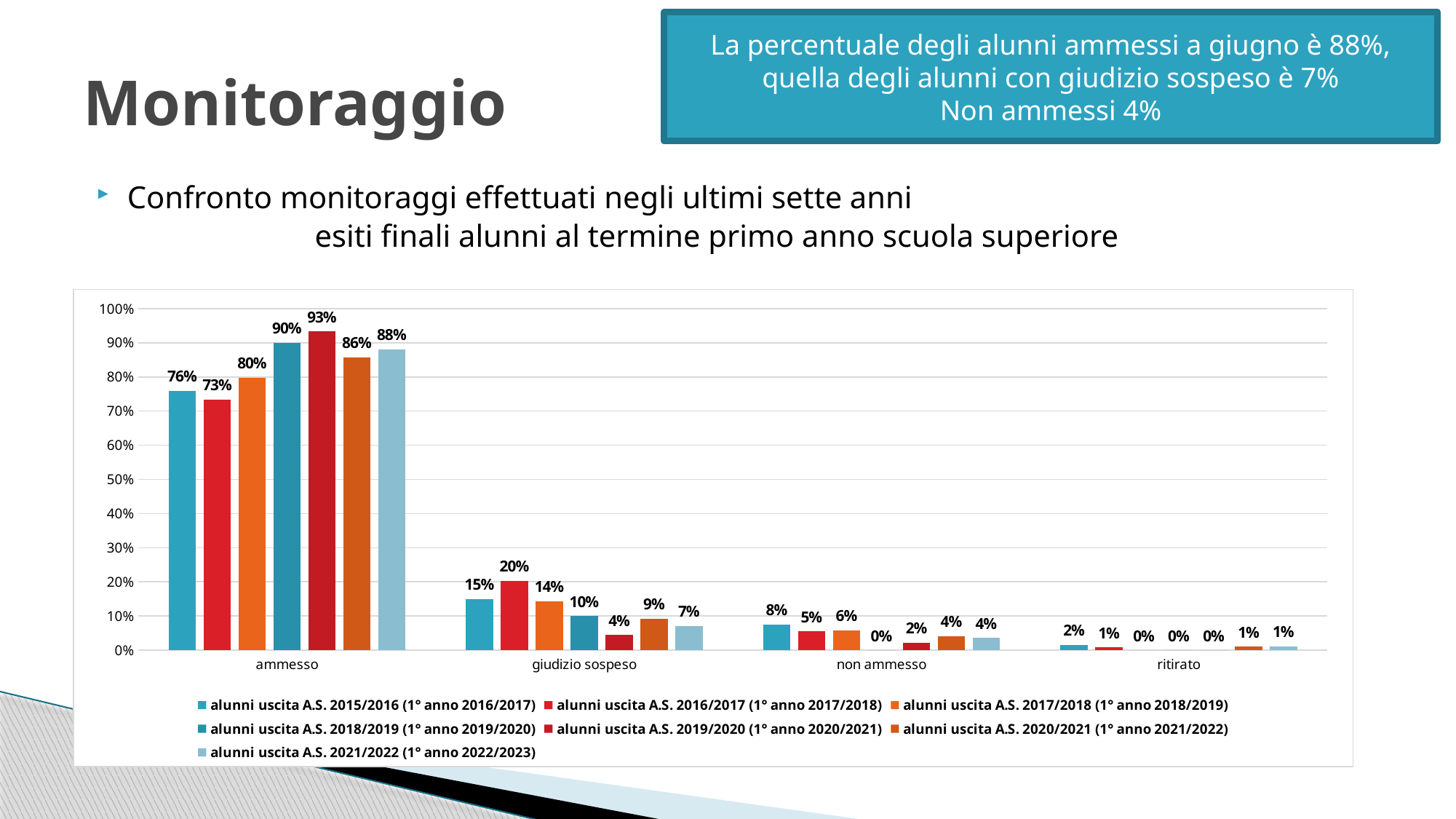
What kind of chart is shown on the slide? bar chart Which series has the lowest value for 'ammesso'? alunni uscita A.S. 2016/2017 (1° anno 2017/2018) How many categories are shown on the x axis of the chart? 4 For 'giudizio sospeso', which is larger: the value for 'alunni uscita A.S. 2017/2018 (1° anno 2018/2019)' or for 'alunni uscita A.S. 2018/2019 (1° anno 2019/2020)'? alunni uscita A.S. 2017/2018 (1° anno 2018/2019) Is the 'ammesso' value for 'alunni uscita A.S. 2018/2019 (1° anno 2019/2020)' greater or less than 80%? greater What is the value for 'non ammesso' for the series 'alunni uscita A.S. 2015/2016 (1° anno 2016/2017)'? 8% How many series does the chart's legend list? 7 What is the value for 'ritirato' for the series 'alunni uscita A.S. 2015/2016 (1° anno 2016/2017)'? 2% Which series has the highest value for 'ammesso'? alunni uscita A.S. 2019/2020 (1° anno 2020/2021) What is the value for 'ammesso' for the series 'alunni uscita A.S. 2021/2022 (1° anno 2022/2023)'? 88% What is the value for 'giudizio sospeso' for the series 'alunni uscita A.S. 2016/2017 (1° anno 2017/2018)'? 20% What is the difference between the 'ammesso' values for the series 'alunni uscita A.S. 2019/2020 (1° anno 2020/2021)' and 'alunni uscita A.S. 2015/2016 (1° anno 2016/2017)'? 17%